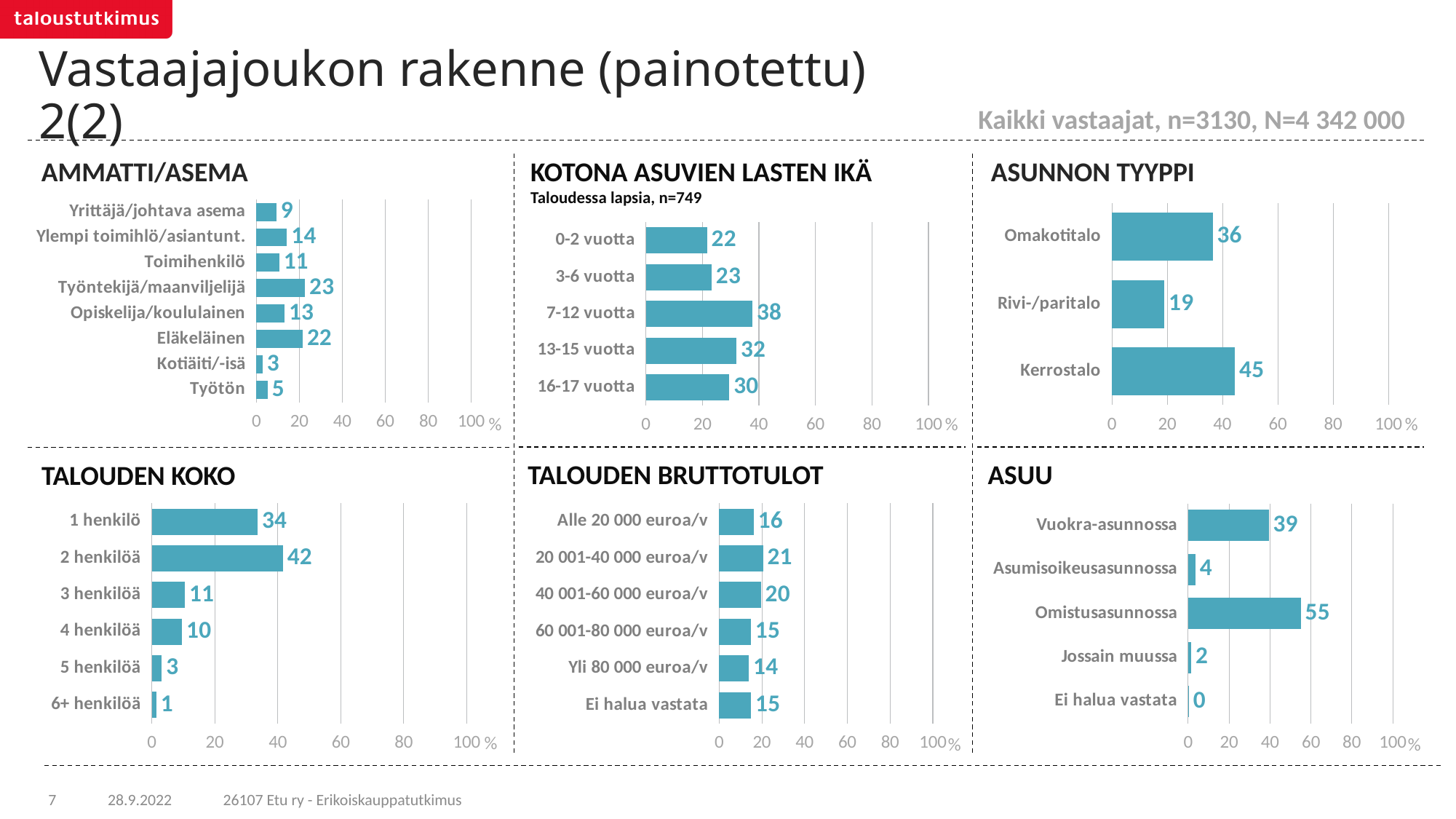
What type of chart is the ASUU chart? Bar chart In the ASUU chart, what is the value for Omistusasunnossa? 55 In the TALOUDEN BRUTTOTULOT chart, how many income categories are shown? 6 In the KOTONA ASUVIEN LASTEN IKÄ chart, which age group has the highest value? 7-12 vuotta In the TALOUDEN BRUTTOTULOT chart, which is larger: 20 001-40 000 euroa/v or 40 001-60 000 euroa/v? 20 001-40 000 euroa/v In the ASUNNON TYYPPI chart, how many categories are shown? 3 In the TALOUDEN KOKO chart, which category has the highest value? 2 henkilöä In the KOTONA ASUVIEN LASTEN IKÄ chart, what is the difference between 7-12 vuotta and 0-2 vuotta? 16 In the ASUNNON TYYPPI chart, what is the value for Kerrostalo? 45 In the AMMATTI/ASEMA chart, what is the value for Työntekijä/maanviljelijä? 23 In the AMMATTI/ASEMA chart, which category has the lowest value? Kotiäiti/-isä In the TALOUDEN KOKO chart, is the value for 1 henkilö greater or less than 20? greater